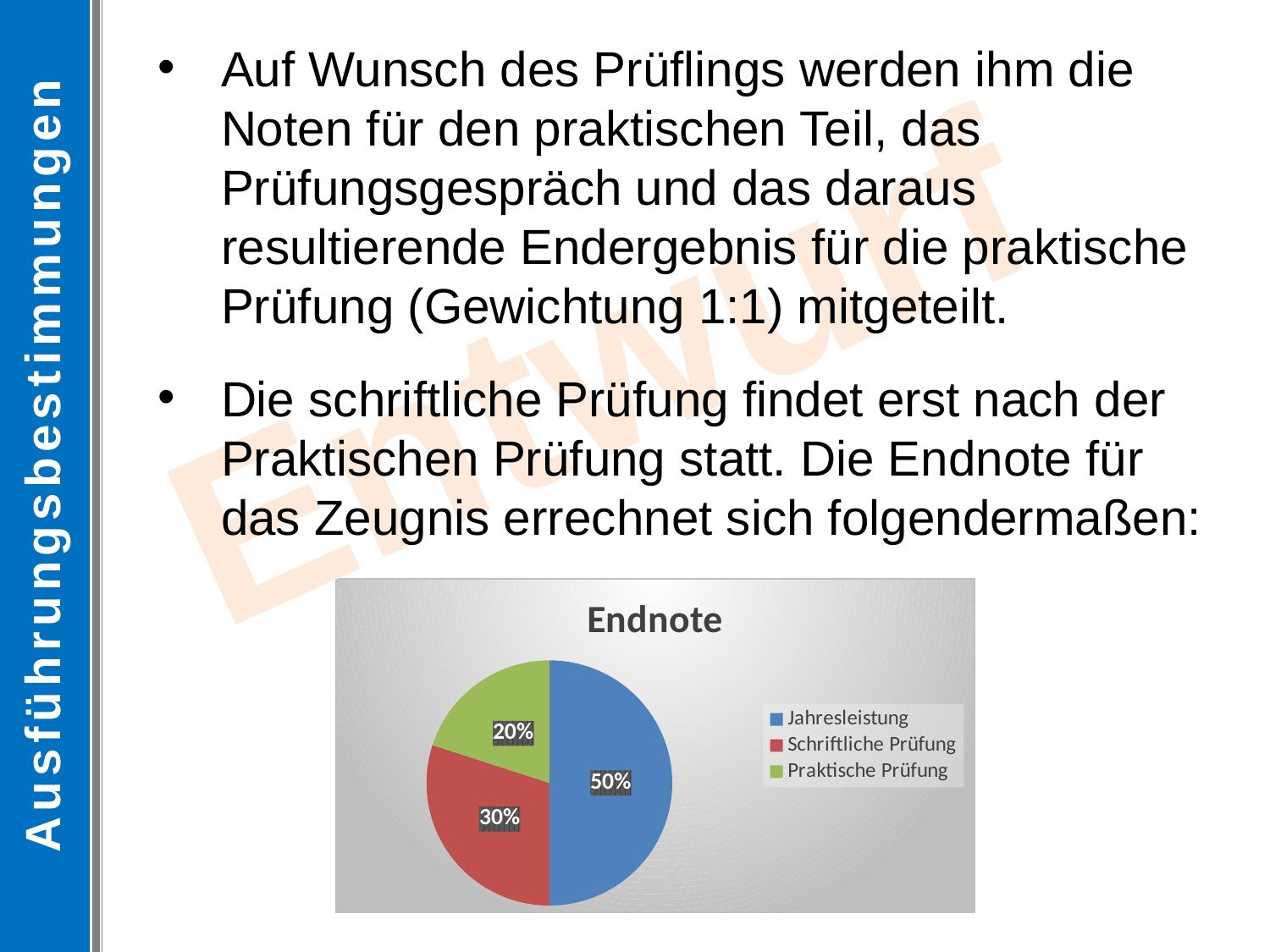
What is the difference in percentage points between Jahresleistung and Schriftliche Prüfung? 20% How many slices does the pie chart have? 3 Which category has the smallest slice of the pie? Praktische Prüfung Which is larger, the share for Schriftliche Prüfung or the share for Praktische Prüfung? Schriftliche Prüfung What share of the pie does Praktische Prüfung have? 20% What is the title of the chart? Endnote Which category has the largest slice of the pie? Jahresleistung Which colour represents Praktische Prüfung in the chart? green How many entries does the legend list? 3 What share of the pie does Jahresleistung have? 50% What share of the pie does Schriftliche Prüfung have? 30% What kind of chart is shown on the slide? pie chart